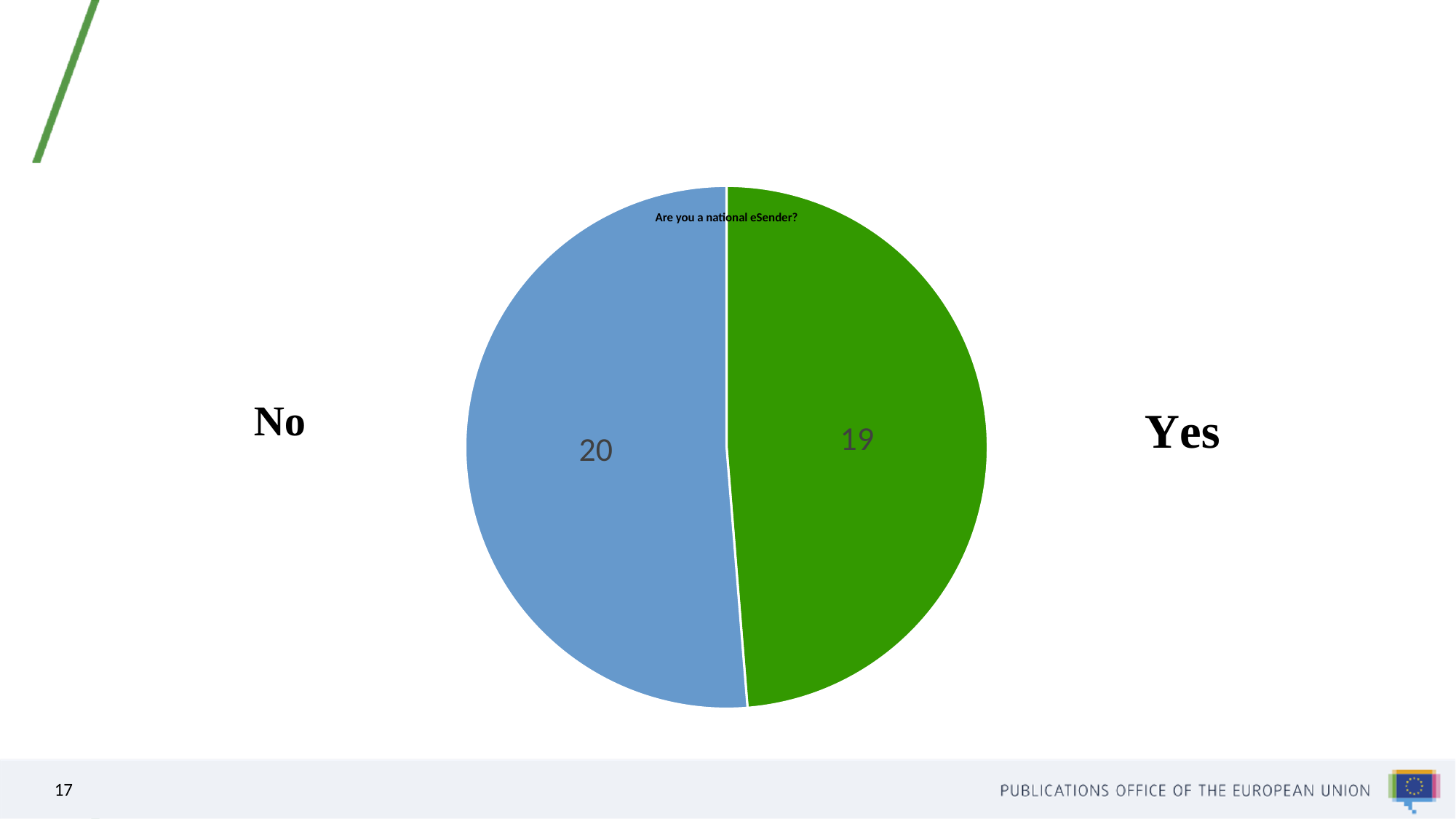
Which response has the smallest slice in the pie chart? Yes What is the difference between the "No" and "Yes" values in the pie chart? 1 How many slices does the pie chart have? 2 Which response has the largest slice in the pie chart? No What kind of chart is shown on the slide? pie chart Which response has the larger slice in the pie chart, "No" or "Yes"? No What is the value of the "Yes" slice in the pie chart? 19 What is the total of the two slices in the pie chart? 39 What is the title of the pie chart? Are you a national eSender? What is the value of the "No" slice in the pie chart? 20 What colour is the "Yes" slice in the pie chart? green